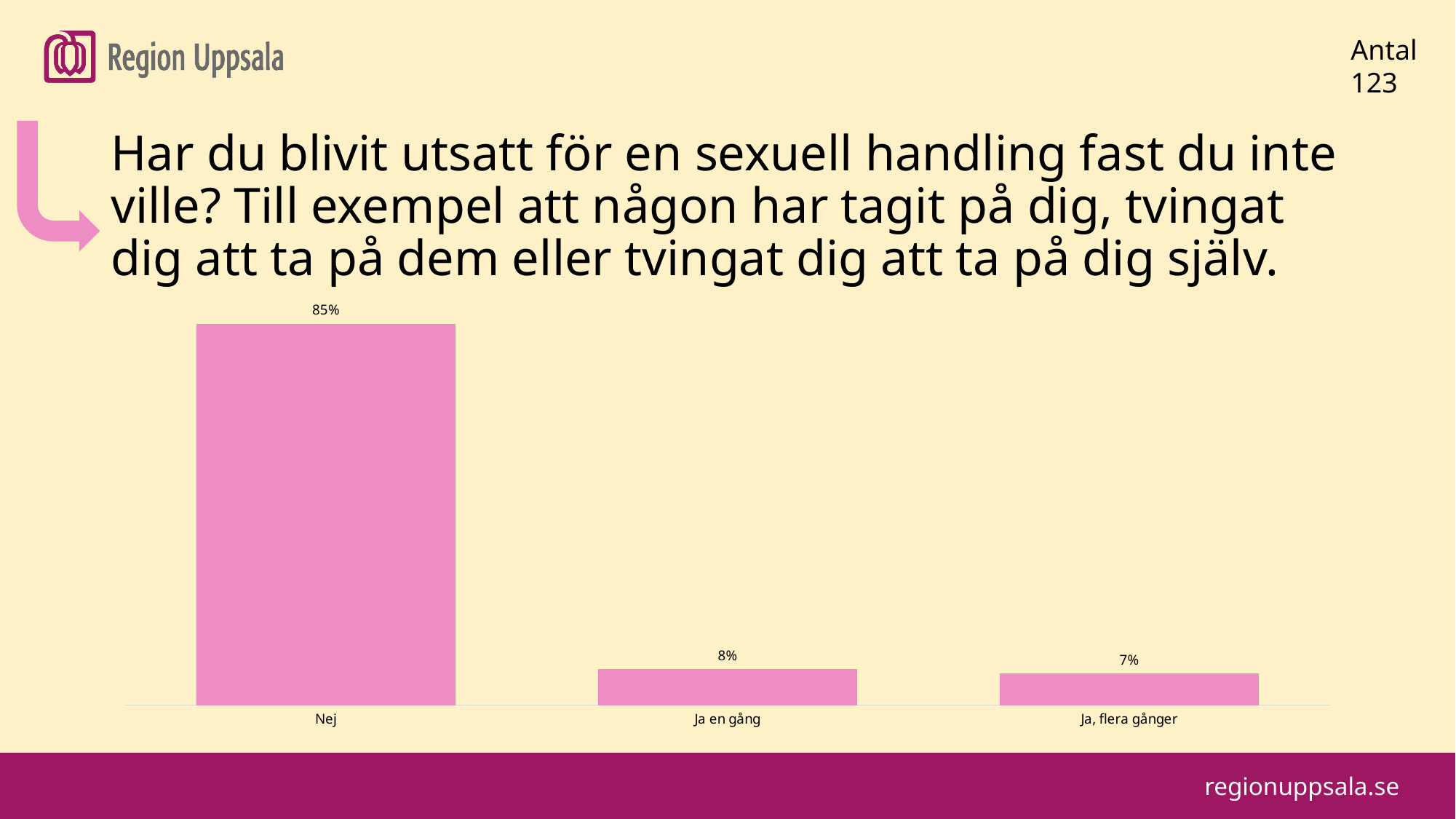
Which category has the highest value? Nej How many categories are shown in the chart? 3 What is the value for "Ja, flera gånger"? 7% What is the difference between the values for "Ja en gång" and "Ja, flera gånger"? 1% Which category has the lowest value? Ja, flera gånger What kind of chart is shown on the slide? Bar chart What is the value for "Nej"? 85% What is the difference between the values for "Nej" and "Ja en gång"? 77% What is the value for "Ja en gång"? 8% What is the number shown under "Antal" in the top right corner of the slide? 123 What colour are the bars in the chart? Pink Which is larger, the value for "Nej" or the value for "Ja, flera gånger"? Nej